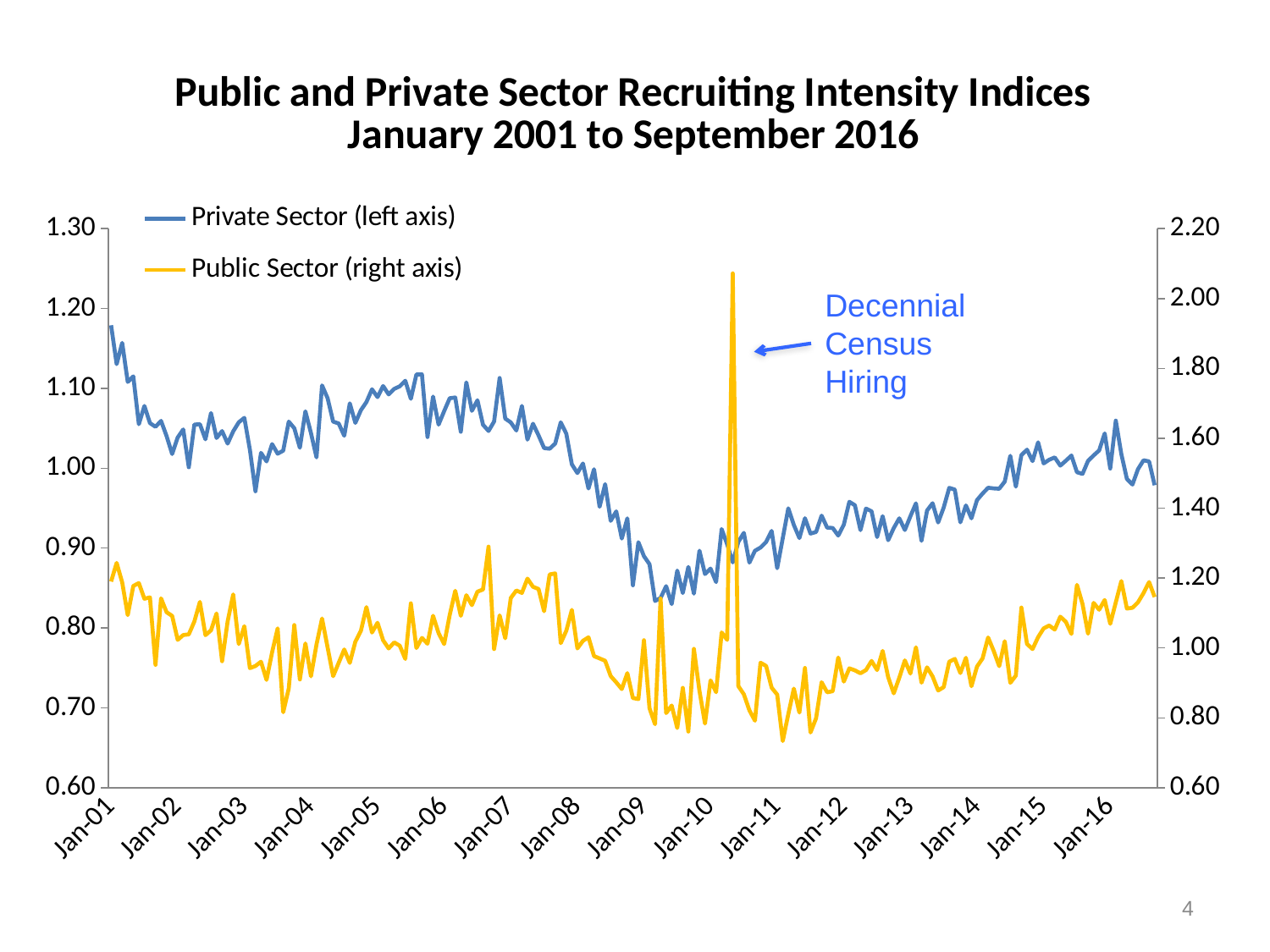
Between which two x-axis labels does the Public Sector spike occur? Jan-10 and Jan-11 Which series does the 'Decennial Census Hiring' annotation point to? Public Sector Does the Private Sector series rise or fall between Jan-08 and Jan-09? fall What kind of chart is shown on the slide? line chart Is the peak of the Public Sector spike greater or less than 2.00 on the right axis? greater Does the Private Sector series rise or fall between Jan-10 and Jan-15? rise Which is larger for the Private Sector series: the value at Jan-01 or the value at Jan-09? Jan-01 Which series is plotted against the right axis? Public Sector How many series does the legend list? 2 Is the Private Sector value at Jan-01 greater or less than 1.10 on the left axis? greater Is the Public Sector value at Jan-01 greater or less than 1.00 on the right axis? greater